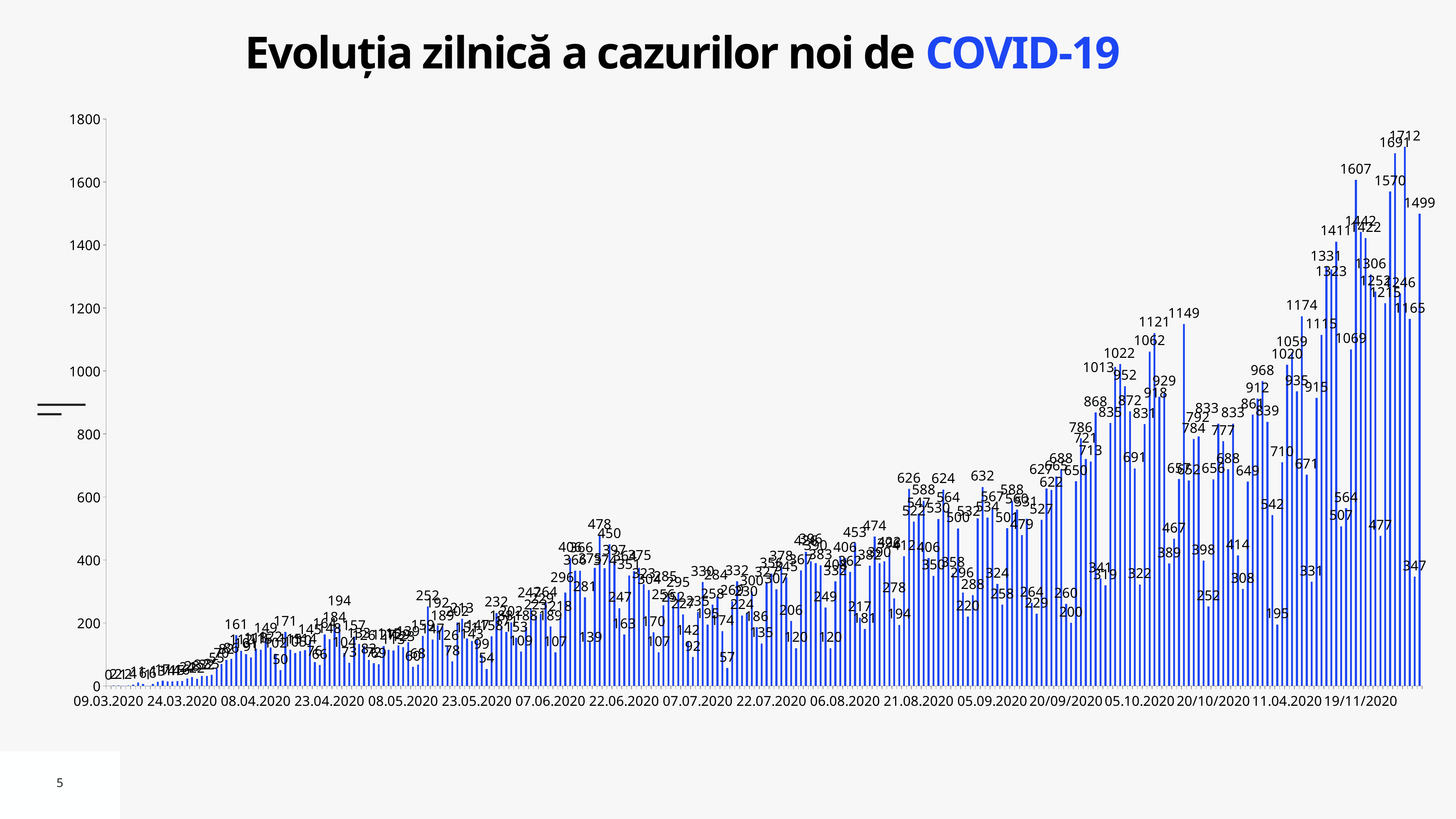
Is the value for 09.03.2020 greater or less than 200? less Overall, do the daily values rise or fall from 09.03.2020 to the end of the series? rise What is the title of the chart? Evoluția zilnică a cazurilor noi de COVID-19 What is the highest daily value labelled on the chart? 1712 What is the highest tick value shown on the vertical axis? 1800 What kind of chart is shown on the slide? bar chart Which is larger, the bar labelled 1607 or the bar labelled 1712? 1712 What is the difference between the two highest labelled values, 1712 and 1691? 21 Is the highest bar on the chart greater or less than 1600? greater What is the lowest value labelled on the chart, at the start of the series? 0